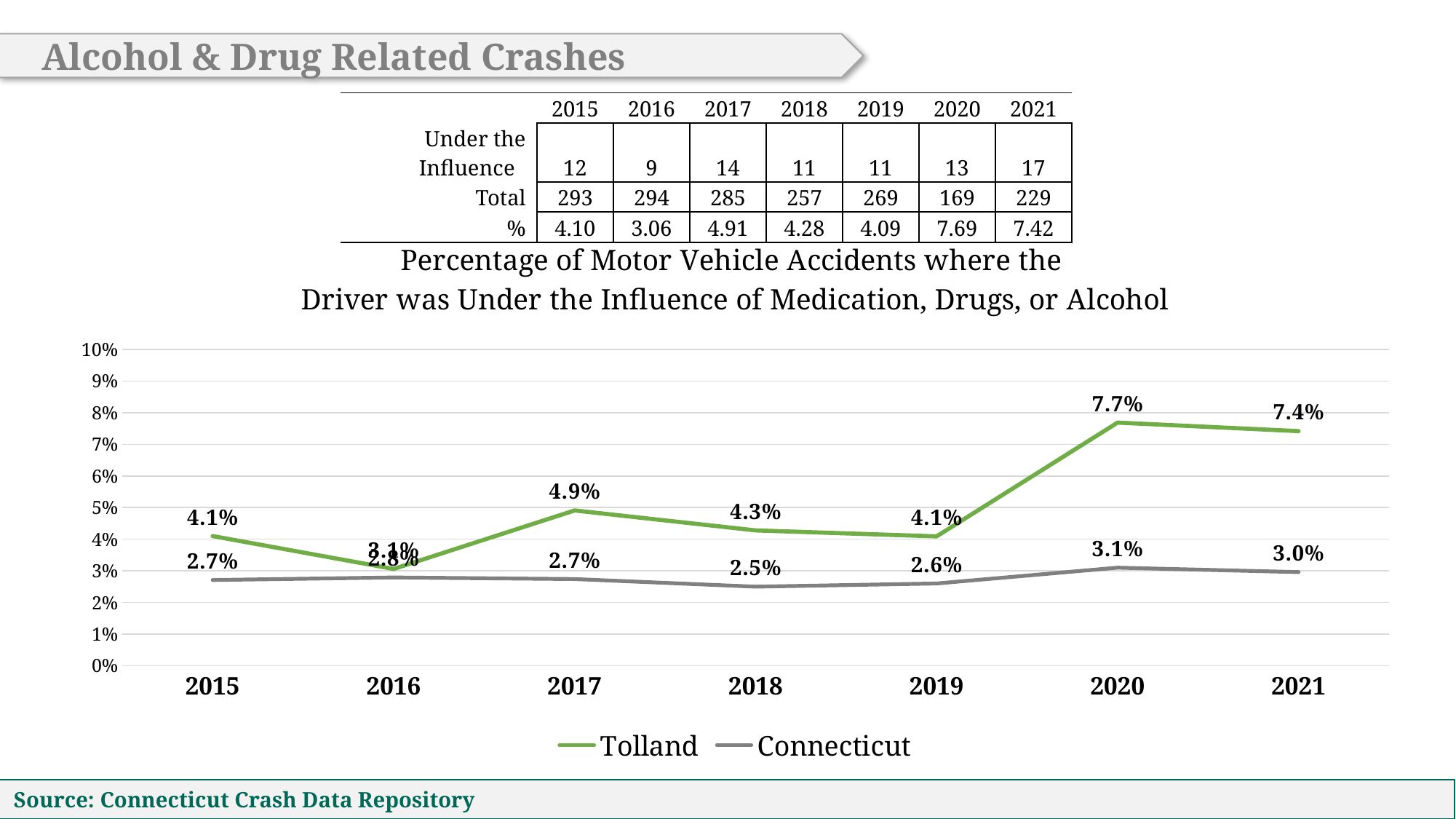
How many series does the chart legend list? 2 What type of chart is shown on the slide? line chart In which year is the Tolland value highest? 2020 What is the difference between the Tolland and Connecticut values in 2021? 4.4% What is the Tolland value for 2020? 7.7% In which year is the Connecticut value lowest? 2018 What is the Connecticut value for 2018? 2.5% What colour is the Tolland line in the chart? green How many years are plotted along the x axis of the chart? 7 What is the Tolland value for 2017? 4.9% Which series has the larger value in 2019, Tolland or Connecticut? Tolland Does the Tolland value rise or fall from 2019 to 2020? rise